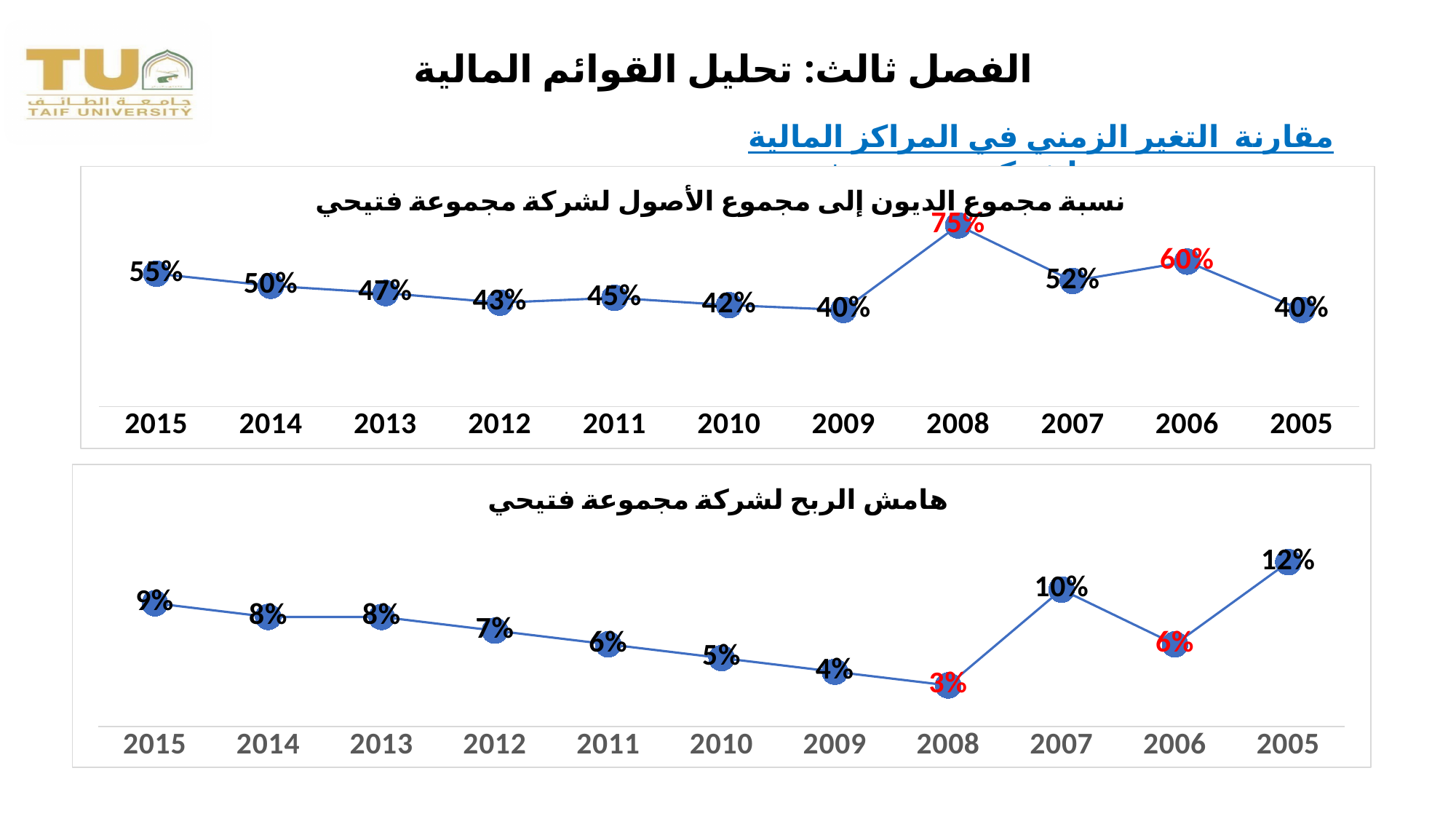
In the top chart (debt to total assets ratio), which year has the highest value? 2008 In the bottom chart (profit margin), do the values rise or fall from 2015 to 2008 along the x axis? Fall In the bottom chart (profit margin), what is the difference between the values for 2005 and 2008? 9% In the bottom chart (profit margin), which year has the lowest value? 2008 In the bottom chart (profit margin), which year has the highest value? 2005 In the top chart (debt to total assets ratio), what is the difference between the values for 2006 and 2007? 8% In the top chart (debt to total assets ratio), what is the value for 2015? 55% What kind of chart is the bottom chart (profit margin)? Line chart In the top chart (debt to total assets ratio), how many years are plotted? 11 In the top chart (debt to total assets ratio), which is larger, the value for 2011 or the value for 2010? 2011 In the bottom chart (profit margin), what is the value for 2007? 10% In the top chart (debt to total assets ratio), what is the value for 2008? 75%